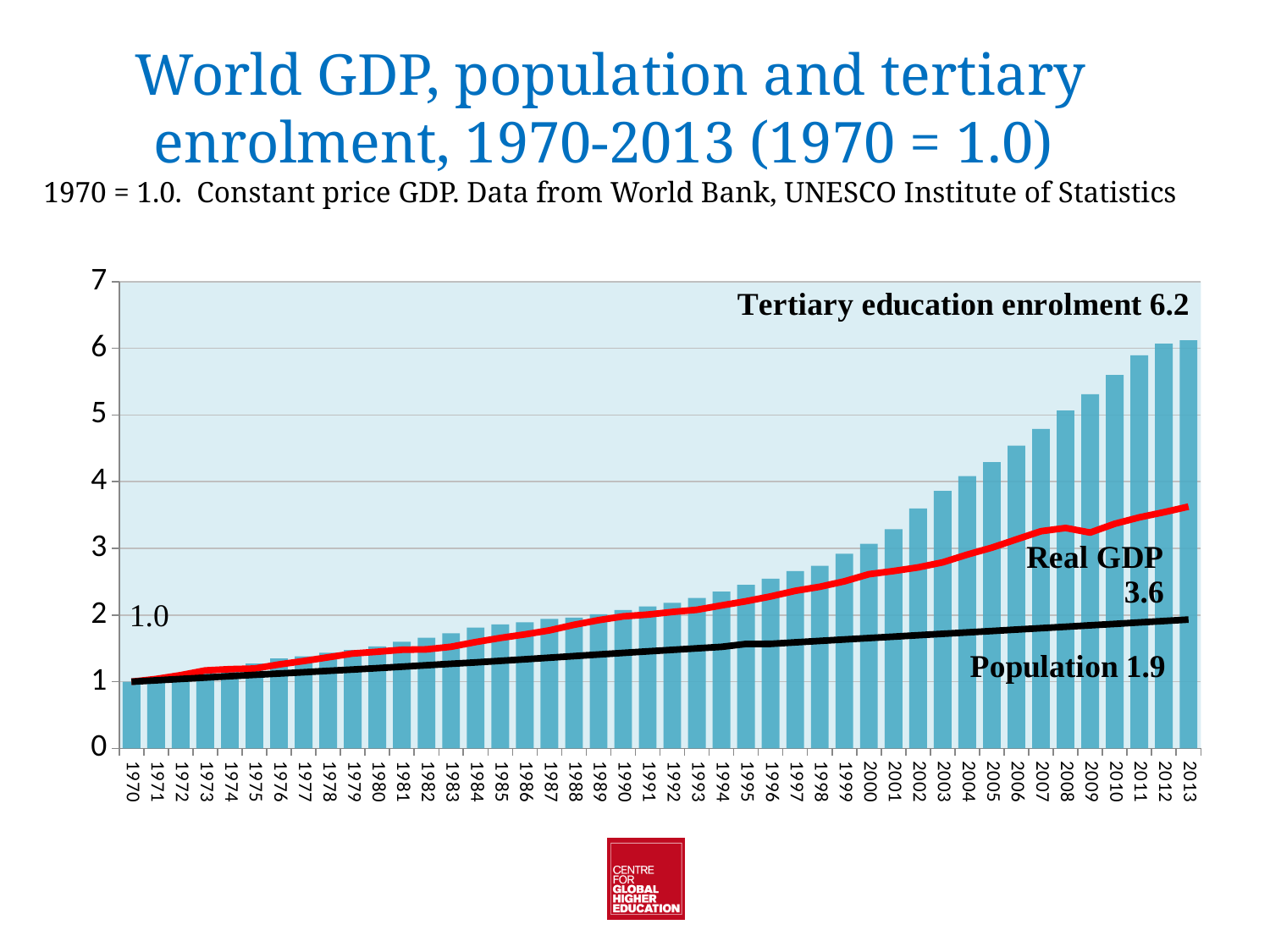
Is the tertiary education enrolment bar for 2010 greater or less than 5? greater What is the value of tertiary education enrolment in 2013? 6.2 Which series has the highest value in 2013? Tertiary education enrolment What is the difference between Real GDP and Population in 2013? 1.7 Is the tertiary education enrolment bar for 1980 greater or less than 2? less What is the index value shown for 1970? 1.0 What is the value of Population in 2013? 1.9 What is the value of Real GDP in 2013? 3.6 How many years are shown on the x axis? 44 What is the difference between tertiary education enrolment and Real GDP in 2013? 2.6 Which series has the lowest value in 2013? Population Do the values of tertiary education enrolment rise or fall from 1970 to 2013? rise